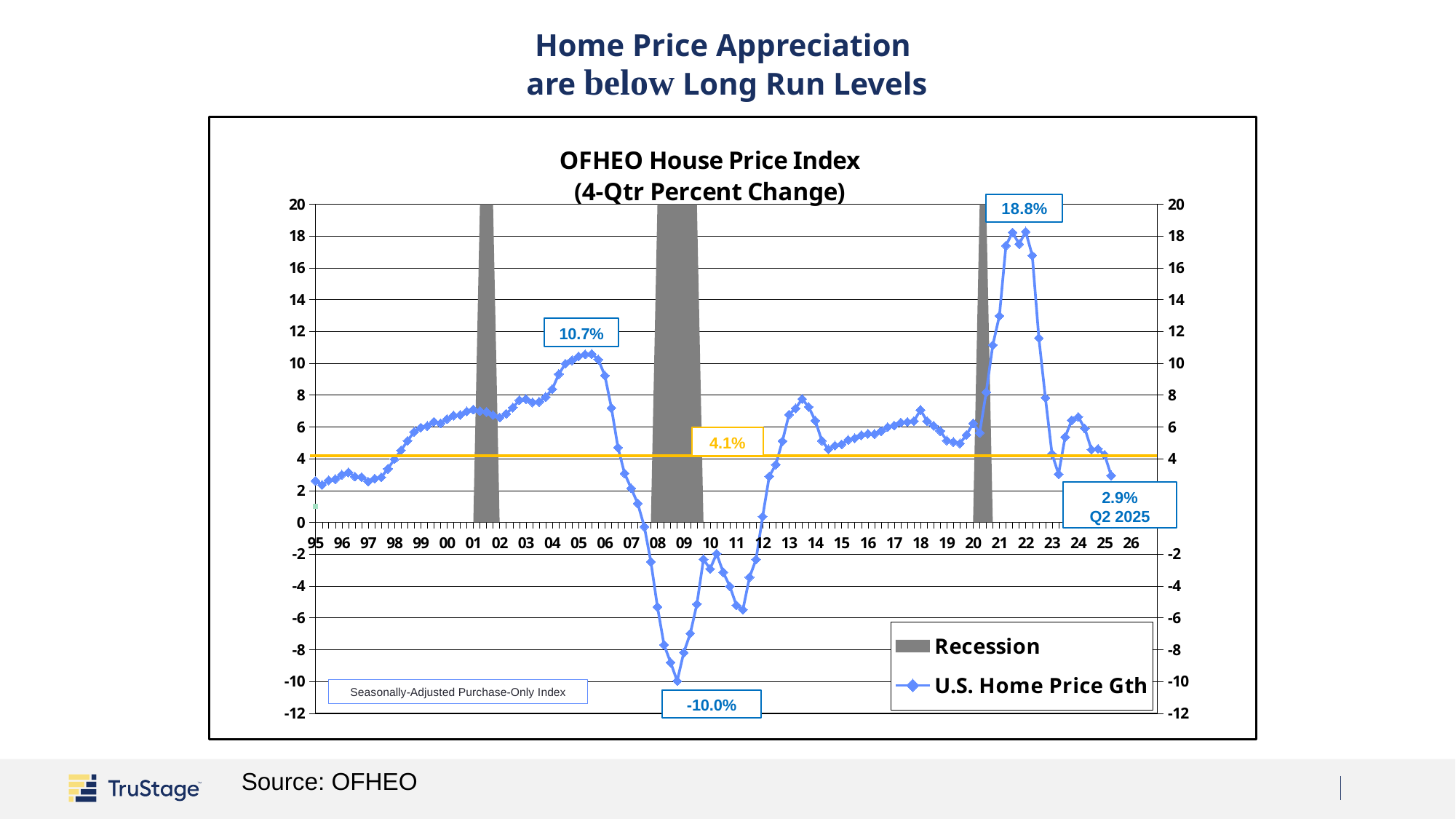
What is the lowest value of U.S. Home Price Gth labeled on the chart, reached around 2009? -10.0% What is the peak value of U.S. Home Price Gth labeled around 2005? 10.7% Which is larger, the peak around 2005 or the peak around 2021-2022? the peak around 2021-2022 How many entries does the chart legend list? 2 Is the Q2 2025 value of 2.9% greater or less than the 4.1% long-run line? less What is the peak value of U.S. Home Price Gth labeled around 2021-2022? 18.8% What is the value of U.S. Home Price Gth labeled for Q2 2025? 2.9% What is the title of the chart? OFHEO House Price Index (4-Qtr Percent Change) What type of chart is shown on the slide? line chart What does the grey shaded area in the chart represent, according to the legend? Recession What is the difference between the 18.8% peak and the 10.7% peak? 8.1% What value is labeled on the horizontal long-run average line? 4.1%